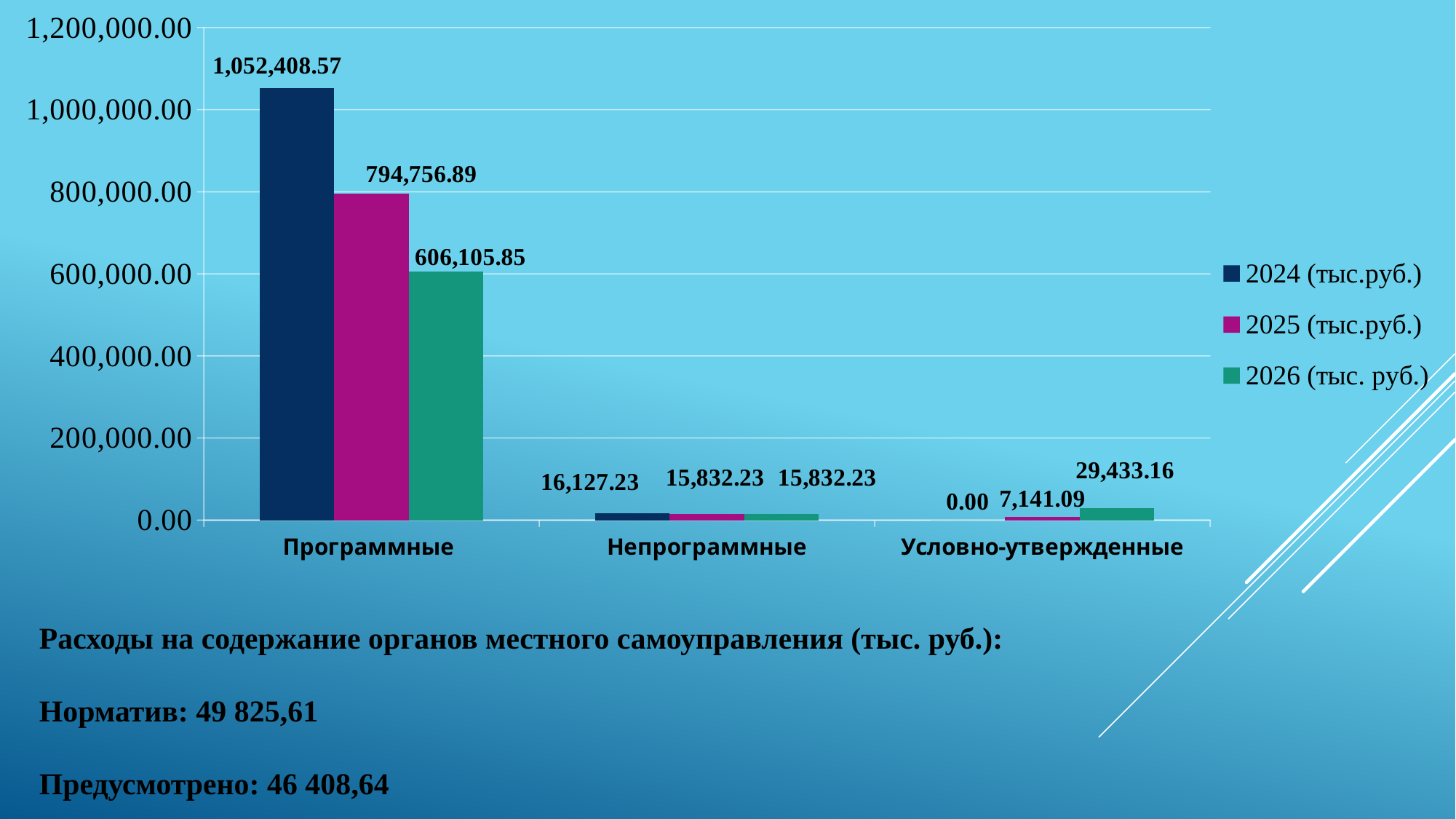
Which category has the highest value in the 2024 (тыс.руб.) series? Программные What is the value for Непрограммные in the 2024 (тыс.руб.) series? 16,127.23 What is the value for Условно-утвержденные in the 2025 (тыс.руб.) series? 7,141.09 Which category has the lowest value in the 2026 (тыс. руб.) series? Непрограммные What is the value for Программные in the 2026 (тыс. руб.) series? 606,105.85 How many series does the legend list? 3 What is the difference between the 2024 and 2025 values for Программные? 257,651.68 What is the difference between the 2026 and 2025 values for Условно-утвержденные? 22,292.07 Which is larger for Программные: the 2025 value or the 2026 value? 2025 How many categories are shown on the x axis? 3 What is the value for Программные in the 2024 (тыс.руб.) series? 1,052,408.57 What kind of chart is shown on the slide? Bar chart